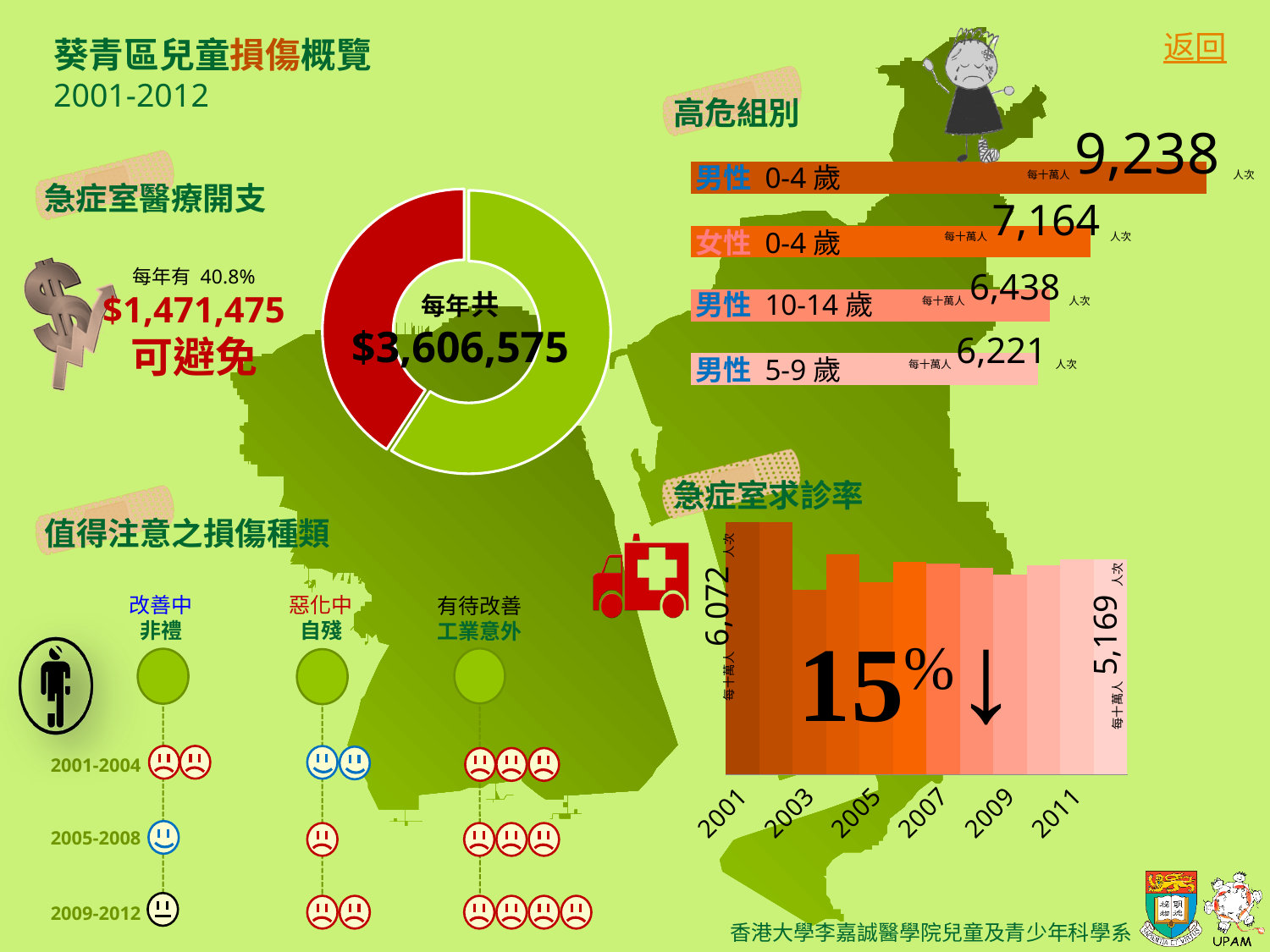
In the 急症室求診率 bar chart, what percentage change is printed on the chart? 15%↓ In the 急症室醫療開支 donut chart, what is the total annual amount shown in the centre? $3,606,575 In the 急症室醫療開支 section, what percentage of the annual expenditure is labelled as avoidable (可避免)? 40.8% In the 高危組別 bar chart, what is the value for 男性 0-4 歲? 9,238 What kind of chart is used in the 急症室醫療開支 section? Donut (pie) chart In the 高危組別 bar chart, how many groups are shown? 4 In the 高危組別 bar chart, which is larger: 男性 10-14 歲 or 男性 5-9 歲? 男性 10-14 歲 In the 高危組別 bar chart, which group has the lowest value? 男性 5-9 歲 In the 急症室求診率 bar chart, what is the value for 2001? 6,072 In the 急症室醫療開支 section, what dollar amount is labelled as avoidable each year? $1,471,475 In the 高危組別 bar chart, what is the difference between 男性 0-4 歲 and 女性 0-4 歲? 2,074 In the 急症室求診率 bar chart, do the values rise or fall from 2001 to the last year? Fall